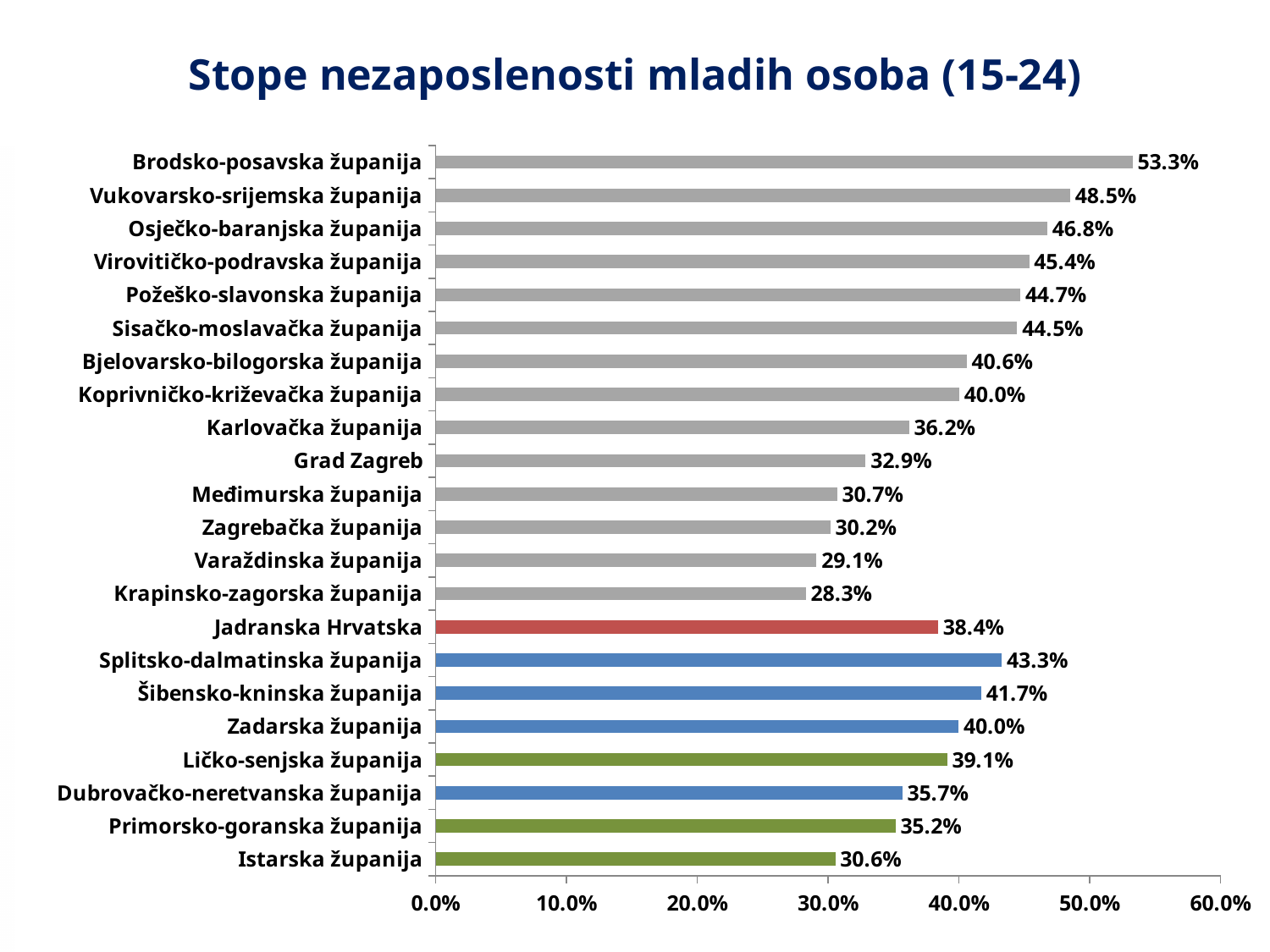
What is the value for Istarska županija? 30.6% Which category has the highest value? Brodsko-posavska županija How many categories are shown in the chart? 22 What is the value for Brodsko-posavska županija? 53.3% Which is larger, the value for Ličko-senjska županija or the value for Jadranska Hrvatska? Ličko-senjska županija Which category has the lowest value? Krapinsko-zagorska županija What is the title of the chart? Stope nezaposlenosti mladih osoba (15-24) What kind of chart is shown on the slide? Bar chart What is the value for Jadranska Hrvatska? 38.4% What is the difference between the values for Brodsko-posavska županija and Vukovarsko-srijemska županija? 4.8% What is the difference between the values for Splitsko-dalmatinska županija and Istarska županija? 12.7% Which is larger, the value for Grad Zagreb or the value for Karlovačka županija? Karlovačka županija